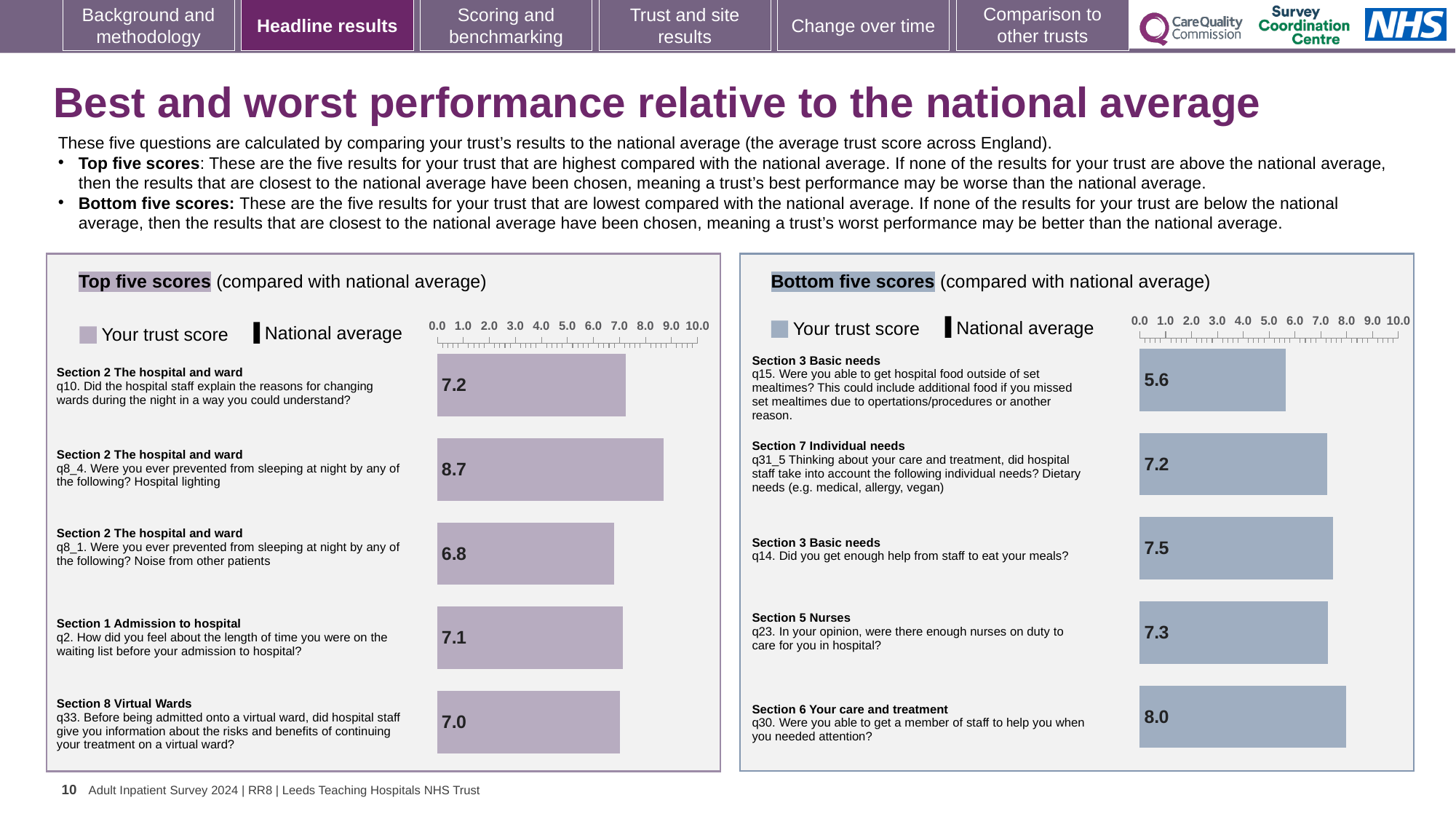
In the Top five scores chart, which question has the lowest trust score? q8_1 Noise from other patients (6.8) In the Bottom five scores chart, what is the trust score for q23 (enough nurses on duty)? 7.3 In the Top five scores chart, what is the difference between the highest score (8.7) and the lowest score (6.8)? 1.9 In the Top five scores chart, what is the trust score for q8_4 (prevented from sleeping at night by hospital lighting)? 8.7 In the Top five scores chart, which question has the highest trust score? q8_4 Hospital lighting (8.7) In the Bottom five scores chart, which question has the highest trust score? q30 Able to get a member of staff to help when you needed attention (8.0) In the Top five scores chart, what is the trust score for q33 about information on risks and benefits of a virtual ward? 7.0 In the Bottom five scores chart, which question has the lowest trust score? q15 Hospital food outside of set mealtimes (5.6) In the Top five scores chart, which has the larger trust score: q10 (explaining reasons for changing wards) or q2 (length of time on the waiting list)? q10 (7.2) What type of chart is used in the Bottom five scores panel? Bar chart In the Bottom five scores chart, what is the trust score for q15 (able to get hospital food outside of set mealtimes)? 5.6 In the Bottom five scores chart, what is the difference between the score for q30 and the score for q15? 2.4